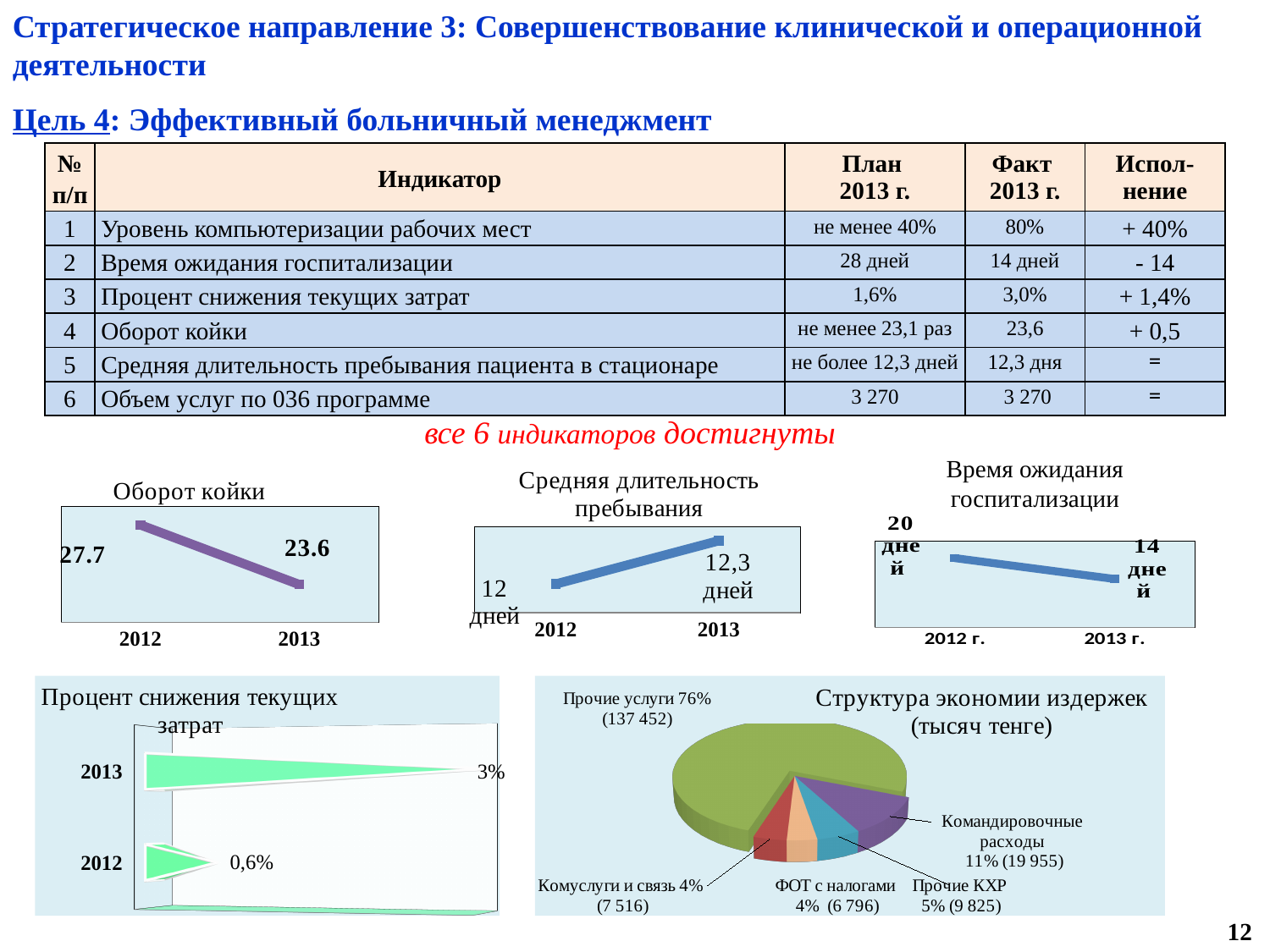
In the chart titled "Время ожидания госпитализации", what is the value for 2013 г.? 14 дней In the chart titled "Средняя длительность пребывания", do the values rise or fall from 2012 to 2013? rise In the chart titled "Процент снижения текущих затрат", which year has the higher value, 2012 or 2013? 2013 In the pie chart titled "Структура экономии издержек (тысяч тенге)", what share does "Прочие услуги" have? 76% In the chart titled "Оборот койки", what is the value for 2013? 23.6 In the chart titled "Оборот койки", do the values rise or fall from 2012 to 2013? fall In the chart titled "Оборот койки", what is the value for 2012? 27.7 In the chart titled "Процент снижения текущих затрат", what is the value for 2012? 0,6% In the pie chart titled "Структура экономии издержек (тысяч тенге)", what is the value for "Командировочные расходы"? 19 955 In the chart titled "Время ожидания госпитализации", what is the value for 2012 г.? 20 дней In the chart titled "Средняя длительность пребывания", what is the value for 2013? 12,3 дней What kind of chart is the chart titled "Структура экономии издержек (тысяч тенге)"? pie chart